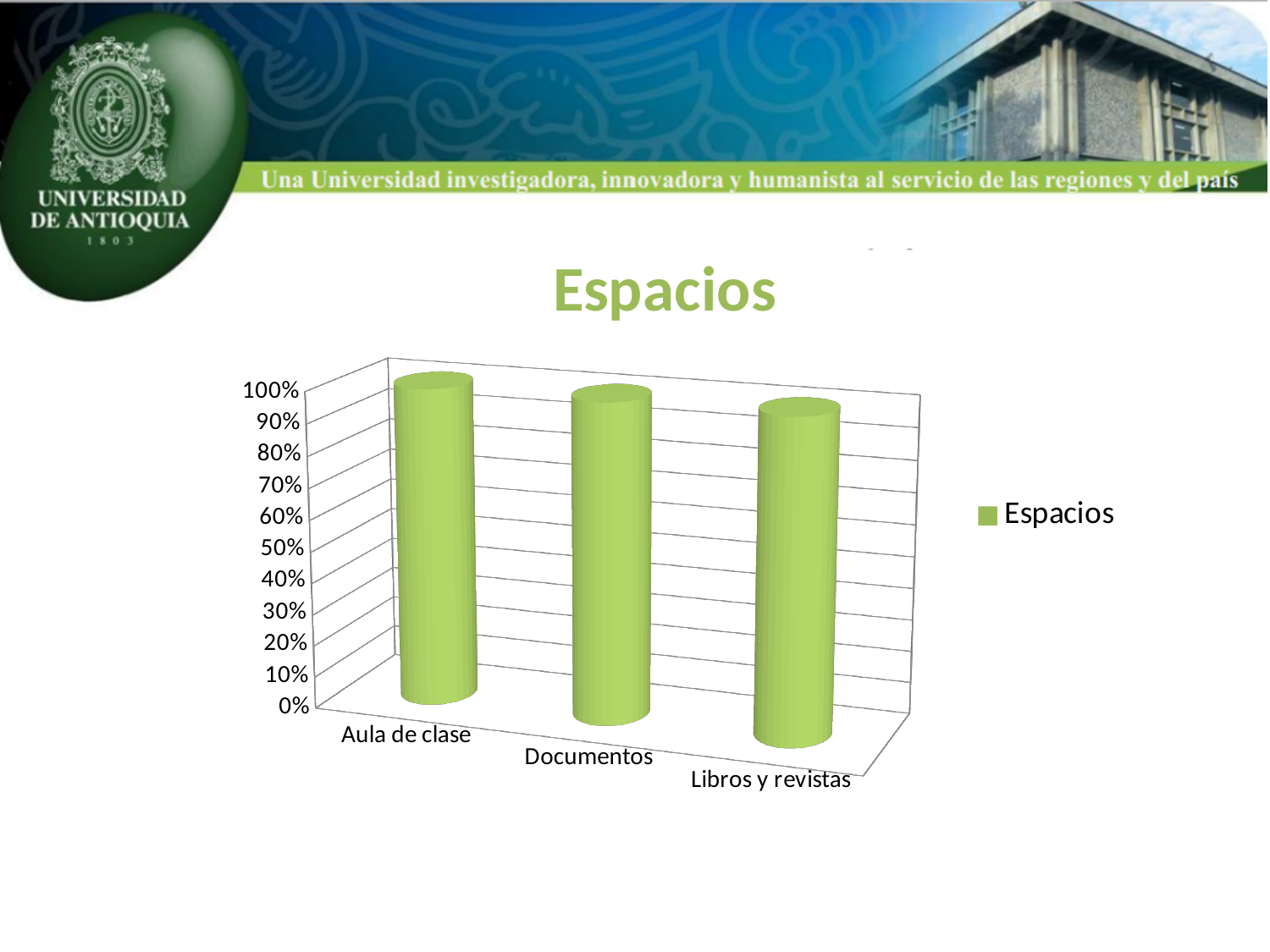
Is the value for Documentos greater or less than 50%? greater How many categories are shown on the x axis of the chart? 3 Is the value for Aula de clase greater or less than 50%? greater What series name appears in the chart's legend? Espacios How many series does the chart's legend list? 1 Is the value for Documentos greater or less than 60%? greater What kind of chart is shown on the slide? bar chart What is the title of the chart? Espacios